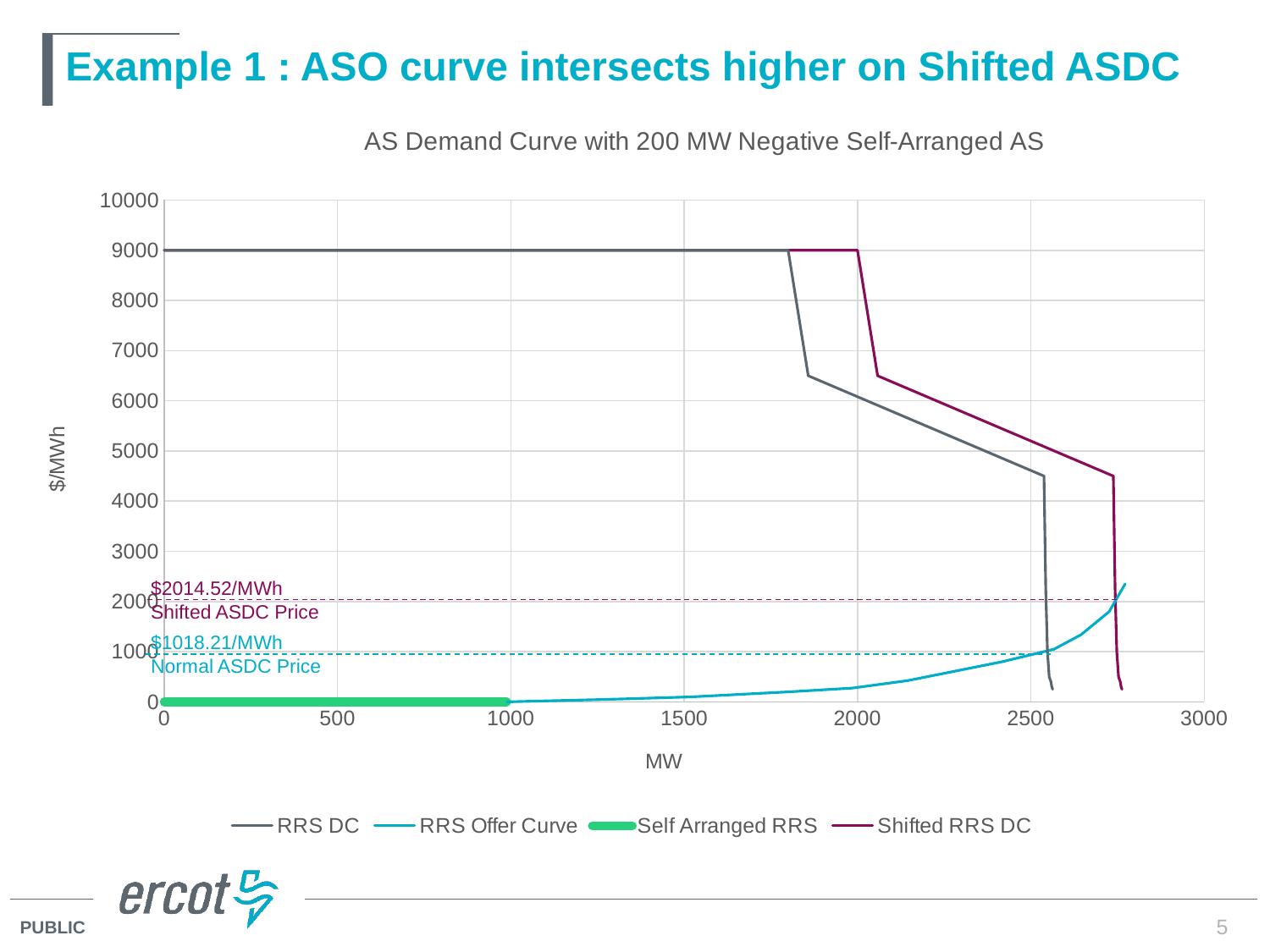
Is the value of the RRS Offer Curve at 2000 MW greater or less than 1000? less Does the RRS Offer Curve rise or fall as MW increases? rise What is the difference between the Shifted ASDC Price and the Normal ASDC Price? $996.31/MWh How many series does the legend list? 4 What is the Shifted ASDC Price shown on the chart? $2014.52/MWh What is the value of the RRS DC series at 1000 MW? 9000 Which is higher, the Shifted ASDC Price or the Normal ASDC Price? Shifted ASDC Price What kind of chart is shown on the slide? line chart What is the label of the vertical axis? $/MWh What is the title of the chart? AS Demand Curve with 200 MW Negative Self-Arranged AS At 2500 MW, which series has the higher value, RRS DC or Shifted RRS DC? Shifted RRS DC What is the Normal ASDC Price shown on the chart? $1018.21/MWh